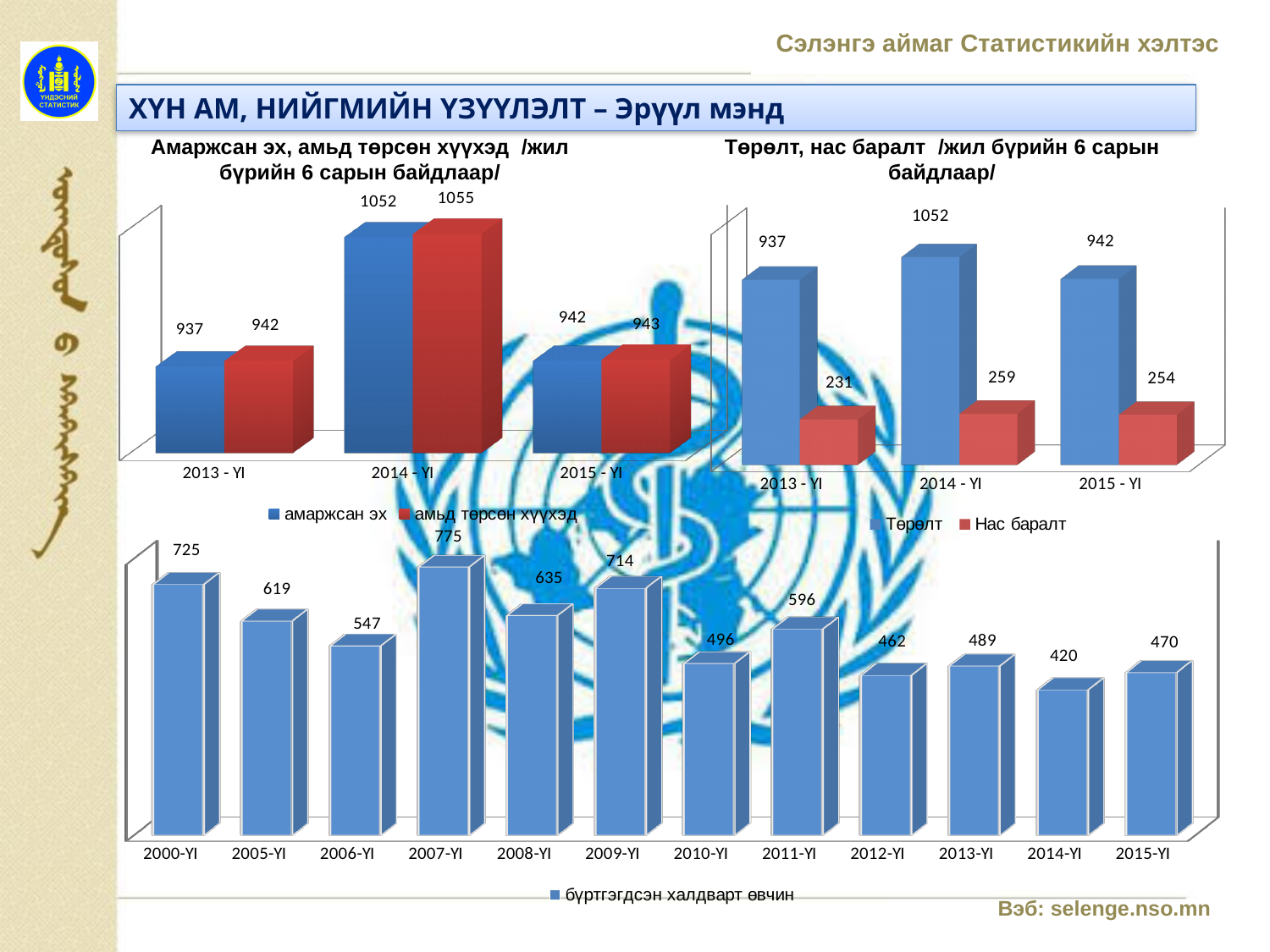
In the top-left chart 'Амаржсан эх, амьд төрсөн хүүхэд', how many series does the legend list? 2 In the top-left chart 'Амаржсан эх, амьд төрсөн хүүхэд', what is the value for амаржсан эх in 2014 - YI? 1052 In the top-right chart 'Төрөлт, нас баралт', which year has the highest Төрөлт value? 2014 - YI In the bottom chart 'бүртгэгдсэн халдварт өвчин', how many years are shown on the x axis? 12 In the top-left chart 'Амаржсан эх, амьд төрсөн хүүхэд', what is the value for амьд төрсөн хүүхэд in 2015 - YI? 943 In the bottom chart 'бүртгэгдсэн халдварт өвчин', what is the value for 2007-YI? 775 In the top-right chart 'Төрөлт, нас баралт', what is the difference between Төрөлт and Нас баралт in 2015 - YI? 688 What type of chart is the bottom chart 'бүртгэгдсэн халдварт өвчин'? Bar chart In the top-right chart 'Төрөлт, нас баралт', which is larger: Нас баралт in 2013 - YI or in 2015 - YI? 2015 - YI In the bottom chart 'бүртгэгдсэн халдварт өвчин', which year has the lowest value? 2014-YI In the top-right chart 'Төрөлт, нас баралт', what is the value for Нас баралт in 2014 - YI? 259 In the top-left chart 'Амаржсан эх, амьд төрсөн хүүхэд', what is the difference between амьд төрсөн хүүхэд and амаржсан эх in 2013 - YI? 5